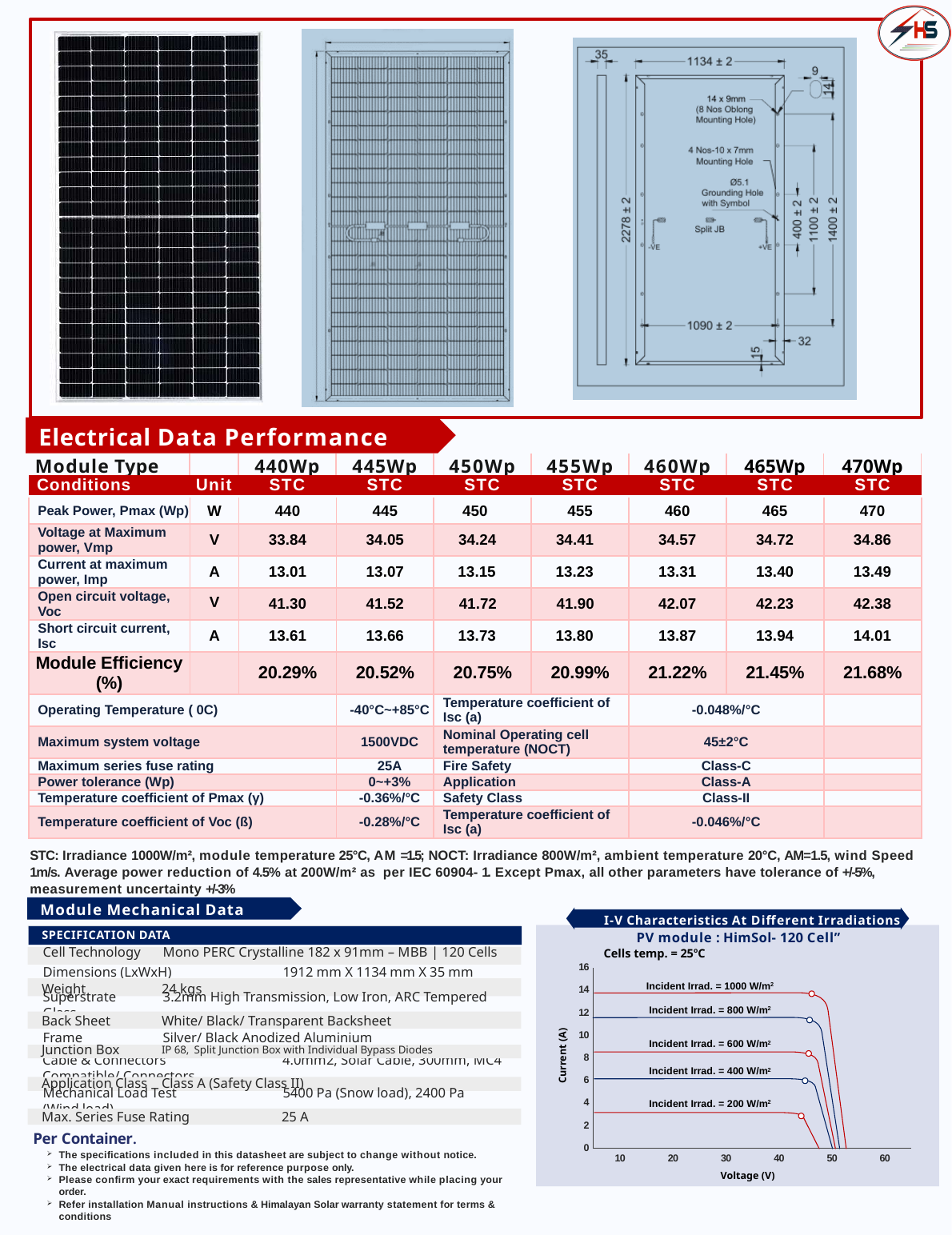
On the I-V Characteristics chart, which curve carries more current: 400 W/m² or 600 W/m²? 600 W/m² On the I-V Characteristics chart, does the current rise or fall as voltage increases toward 50 V? fall On the I-V Characteristics chart, is the current of the 600 W/m² curve at low voltage greater or less than 10 A? less On the I-V Characteristics chart, which incident irradiance curve has the lowest current? Incident Irrad. = 200 W/m² On the I-V Characteristics chart, is the current of the 1000 W/m² curve at low voltage greater or less than 12 A? greater What kind of chart is the I-V Characteristics At Different Irradiations chart? line chart On the I-V Characteristics chart, which incident irradiance curve has the highest current? Incident Irrad. = 1000 W/m² What cell temperature is stated on the I-V Characteristics chart? 25°C How many irradiance curves are plotted on the I-V Characteristics chart? 5 On the I-V Characteristics chart, is the current of the 800 W/m² curve at low voltage greater or less than 10 A? greater What is the label of the vertical axis on the I-V Characteristics chart? Current (A)